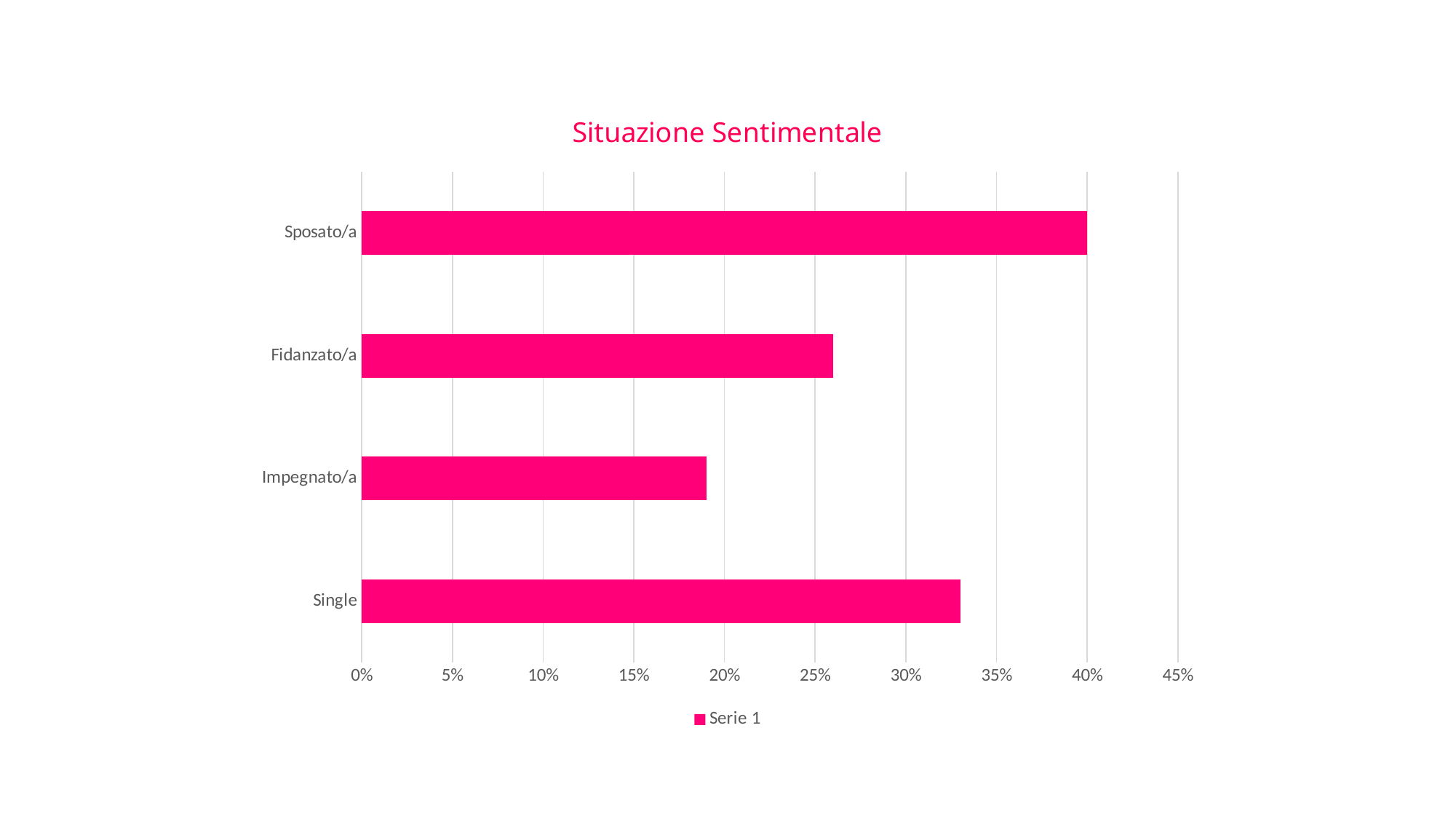
What is the value for Sposato/a? 40% Is the value for Impegnato/a greater or less than 20%? less Which is larger, the value for Single or the value for Fidanzato/a? Single What type of chart is shown on the slide? bar chart Which category has the lowest value? Impegnato/a Which category has the highest value? Sposato/a How many series does the legend list? 1 What is the name of the series shown in the legend? Serie 1 Is the value for Single greater or less than 30%? greater What is the title of the chart? Situazione Sentimentale Is the value for Fidanzato/a greater or less than 25%? greater How many categories are shown in the chart? 4